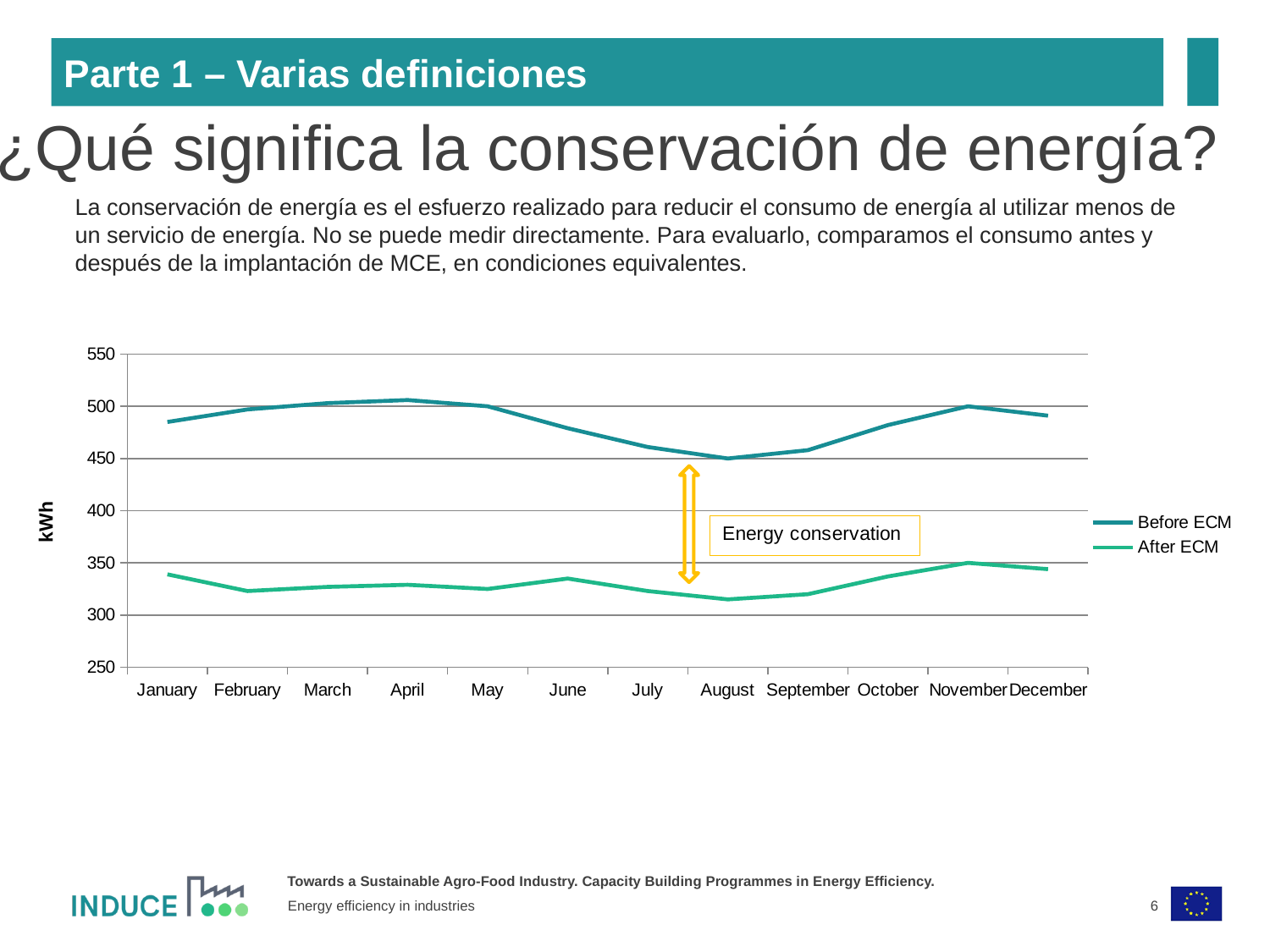
Is the After ECM value for November greater or less than 400? less Does the Before ECM series rise or fall from April to August? fall What label is shown on the y axis of the chart? kWh In which month is the Before ECM series at its lowest? August What kind of chart is shown on the slide? line chart Is the Before ECM value for April greater or less than 500? greater Is the After ECM value for August greater or less than 300? greater How many months are plotted along the x axis? 12 In which month is the After ECM series at its highest? November Which series has the higher value in August, Before ECM or After ECM? Before ECM How many series does the legend list? 2